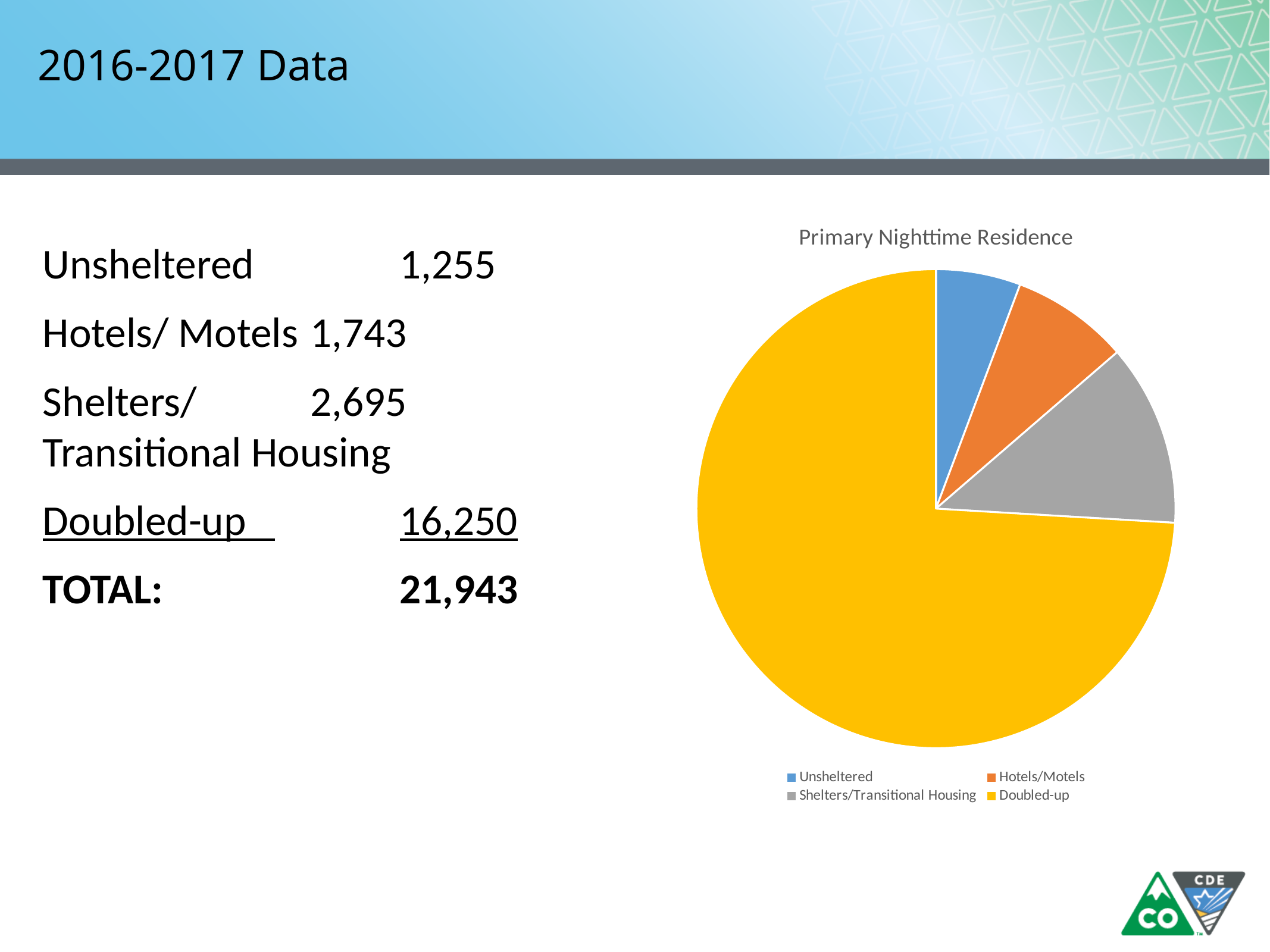
Which category has the smallest slice in the pie chart? Unsheltered What is the title of the chart? Primary Nighttime Residence How many slices does the pie chart have? 4 What type of chart is shown on the slide? Pie chart How many entries does the chart legend list? 4 What is the difference between the Hotels/Motels value and the Unsheltered value? 488 What is the value for Unsheltered? 1,255 What is the value for Doubled-up? 16,250 Which category has the largest slice in the pie chart? Doubled-up What colour is the Doubled-up slice in the pie chart? Yellow Which is larger, the Shelters/Transitional Housing slice or the Hotels/Motels slice? Shelters/Transitional Housing What is the value for Shelters/Transitional Housing? 2,695